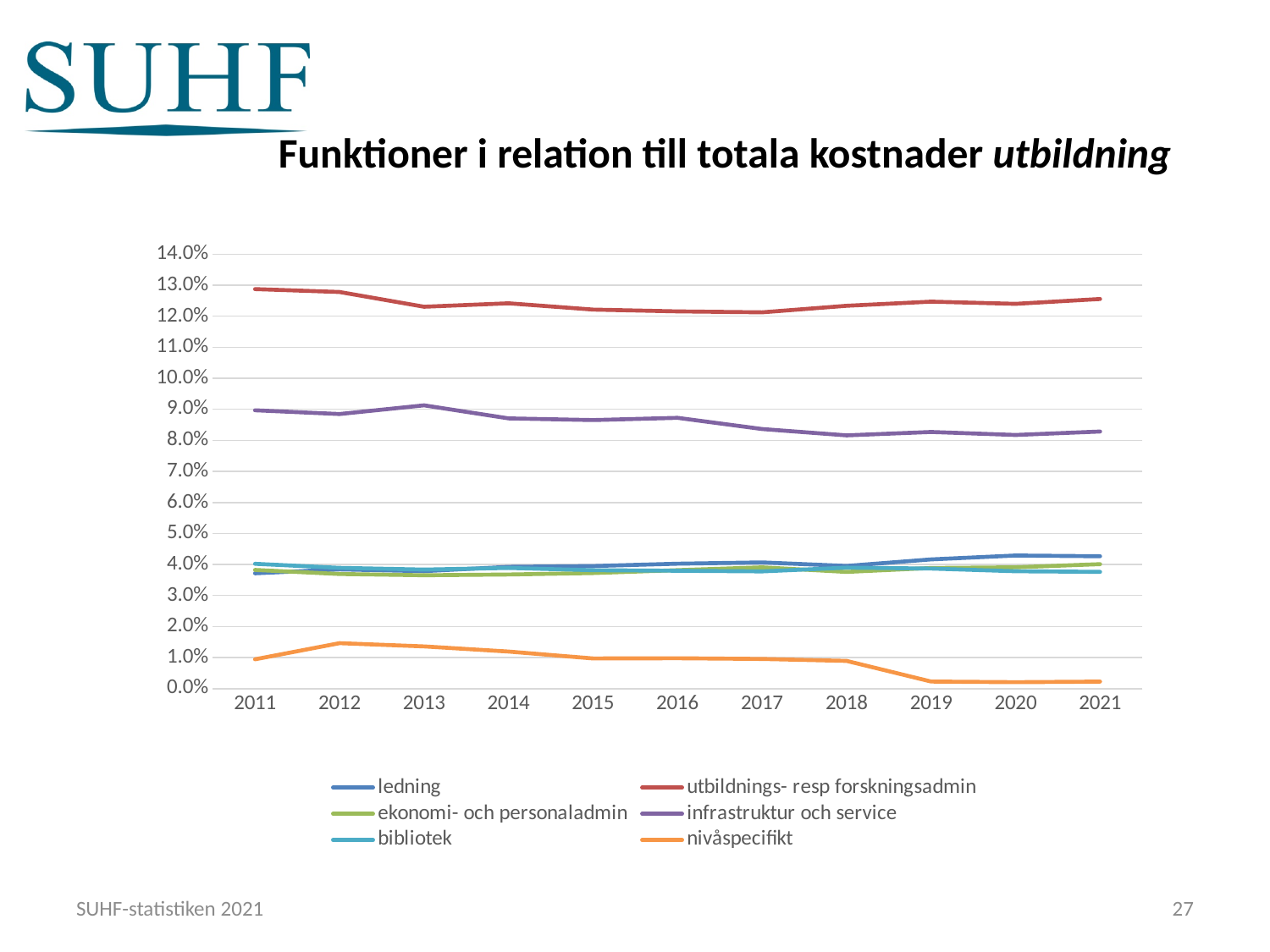
Is the value for nivåspecifikt in 2012 greater or less than 1.0%? greater Is the value for nivåspecifikt in 2019 greater or less than 1.0%? less In 2015, which is larger: infrastruktur och service or ledning? infrastruktur och service What kind of chart is shown on the slide? line chart Is the value for utbildnings- resp forskningsadmin in 2011 greater or less than 12.0%? greater Which series has the lowest values across all years? nivåspecifikt How many series does the legend list? 6 Does the nivåspecifikt series rise or fall from 2012 to 2021? fall What is the title of the chart? Funktioner i relation till totala kostnader utbildning How many years are shown on the x axis? 11 Which series has the highest values across all years? utbildnings- resp forskningsadmin